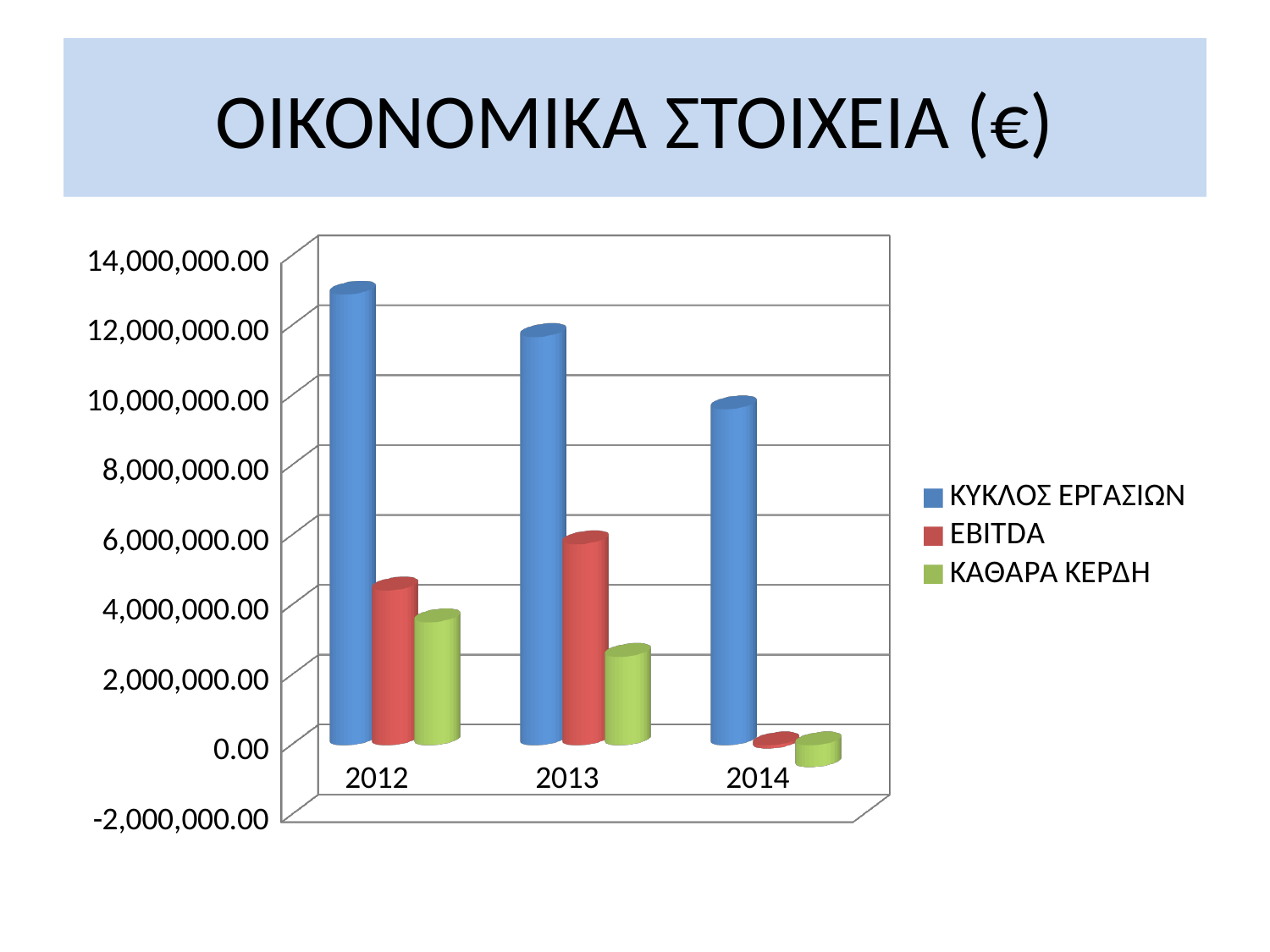
Do the values for ΚΥΚΛΟΣ ΕΡΓΑΣΙΩΝ rise or fall from 2012 to 2014? fall How many years are shown on the x axis? 3 Is the value for EBITDA in 2013 greater or less than 4,000,000.00? greater What kind of chart is shown on the slide? bar chart How many series does the legend list? 3 Which year has the highest value for ΚΥΚΛΟΣ ΕΡΓΑΣΙΩΝ? 2012 Which is larger, EBITDA in 2012 or EBITDA in 2013? EBITDA in 2013 Is the value for ΚΥΚΛΟΣ ΕΡΓΑΣΙΩΝ in 2014 greater or less than 10,000,000.00? less Which year has the highest value for EBITDA? 2013 Is the value for ΚΥΚΛΟΣ ΕΡΓΑΣΙΩΝ in 2012 greater or less than 12,000,000.00? greater What is the title of the slide? ΟΙΚΟΝΟΜΙΚΑ ΣΤΟΙΧΕΙΑ (€) Which year has the lowest value for ΚΥΚΛΟΣ ΕΡΓΑΣΙΩΝ? 2014